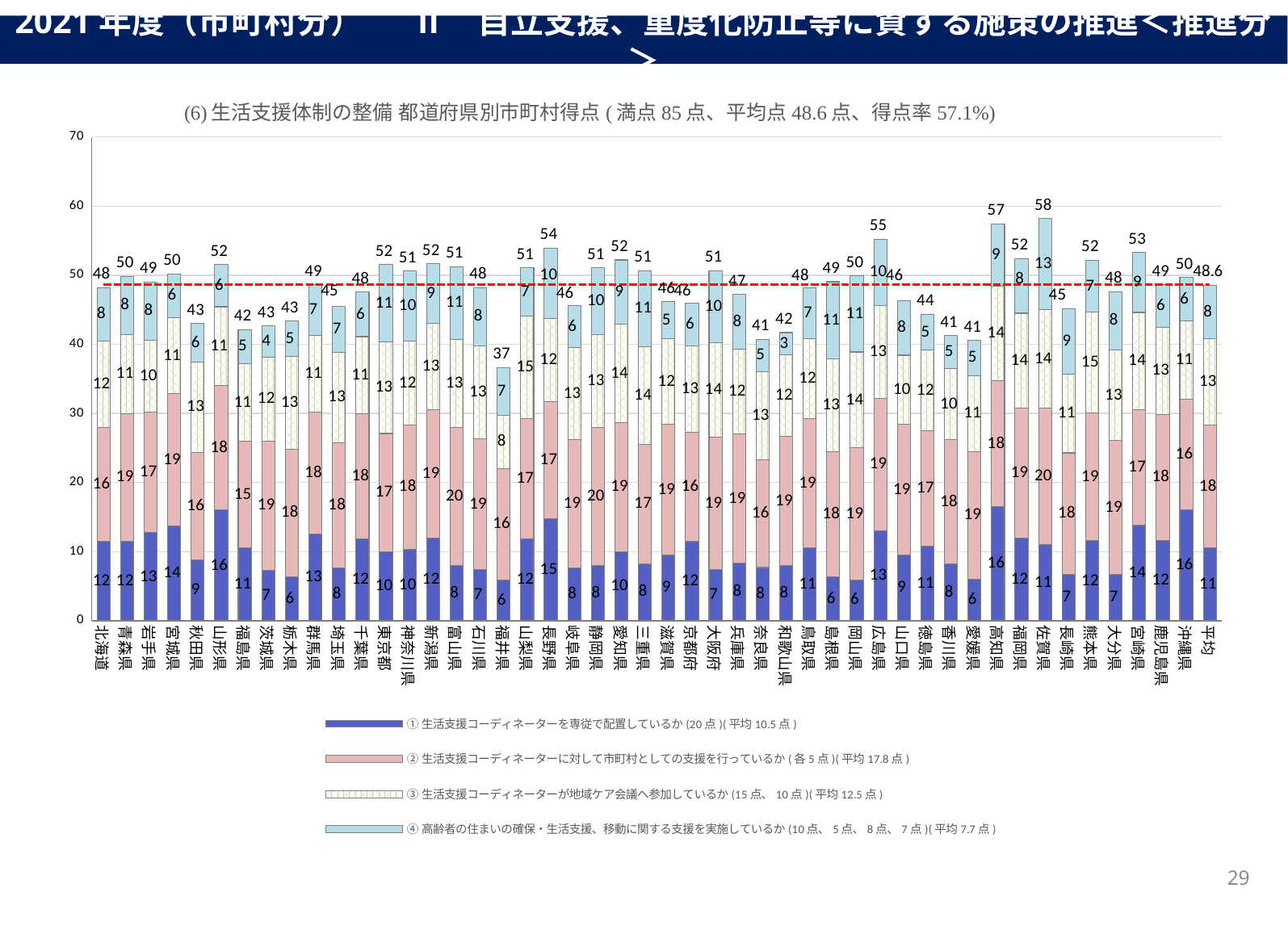
Which prefecture has the lowest total score? 福井県 How many series does the legend list? 4 What is the total score for 北海道? 48 What is the value shown for the 平均 bar at the far right? 48.6 What is the value of the bottom (dark blue, ①) segment for 高知県? 16 Which has a higher total score, 高知県 or 宮崎県? 高知県 What is the total score for 高知県? 57 Is the total score for 福井県 greater or less than 40? less What is the value of the pink (②) segment for 佐賀県? 20 What is the difference between the total score of 佐賀県 and that of 福井県? 21 Which prefecture has the highest total score? 佐賀県 What kind of chart is shown on the slide? stacked bar chart